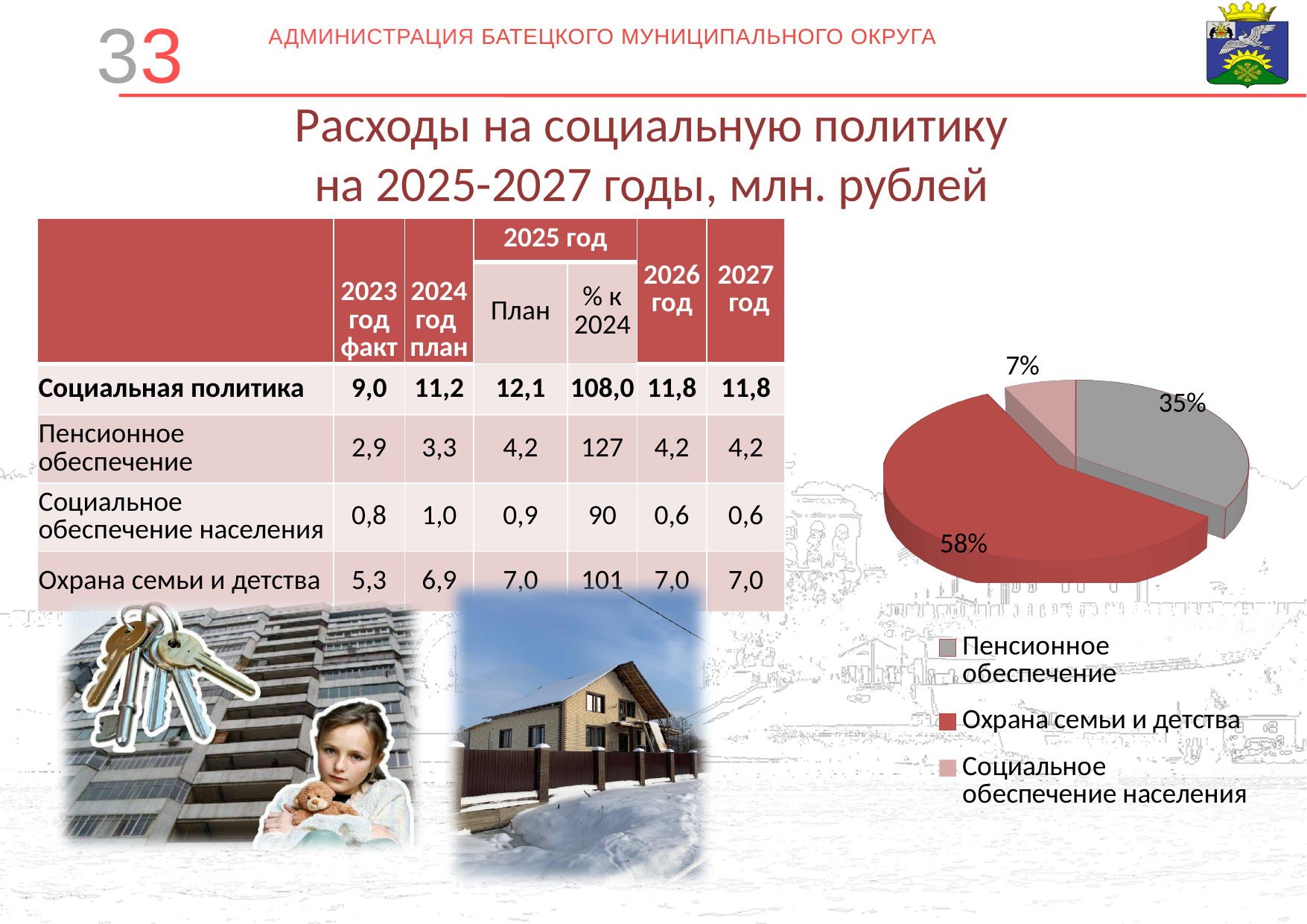
What is the difference in percentage points between the Охрана семьи и детства slice and the Пенсионное обеспечение slice? 23 Which category has the smallest slice in the pie chart? Социальное обеспечение населения What share of the pie chart does Пенсионное обеспечение represent? 35% What is the difference in percentage points between the Пенсионное обеспечение slice and the Социальное обеспечение населения slice? 28 Which slice is larger: Пенсионное обеспечение or Социальное обеспечение населения? Пенсионное обеспечение What share of the pie chart does Охрана семьи и детства represent? 58% What type of chart is shown on the right side of the slide? Pie chart What colour is the Пенсионное обеспечение slice in the pie chart? Grey How many slices does the pie chart have? 3 How many entries does the pie chart legend list? 3 Which category has the largest slice in the pie chart? Охрана семьи и детства What share of the pie chart does Социальное обеспечение населения represent? 7%